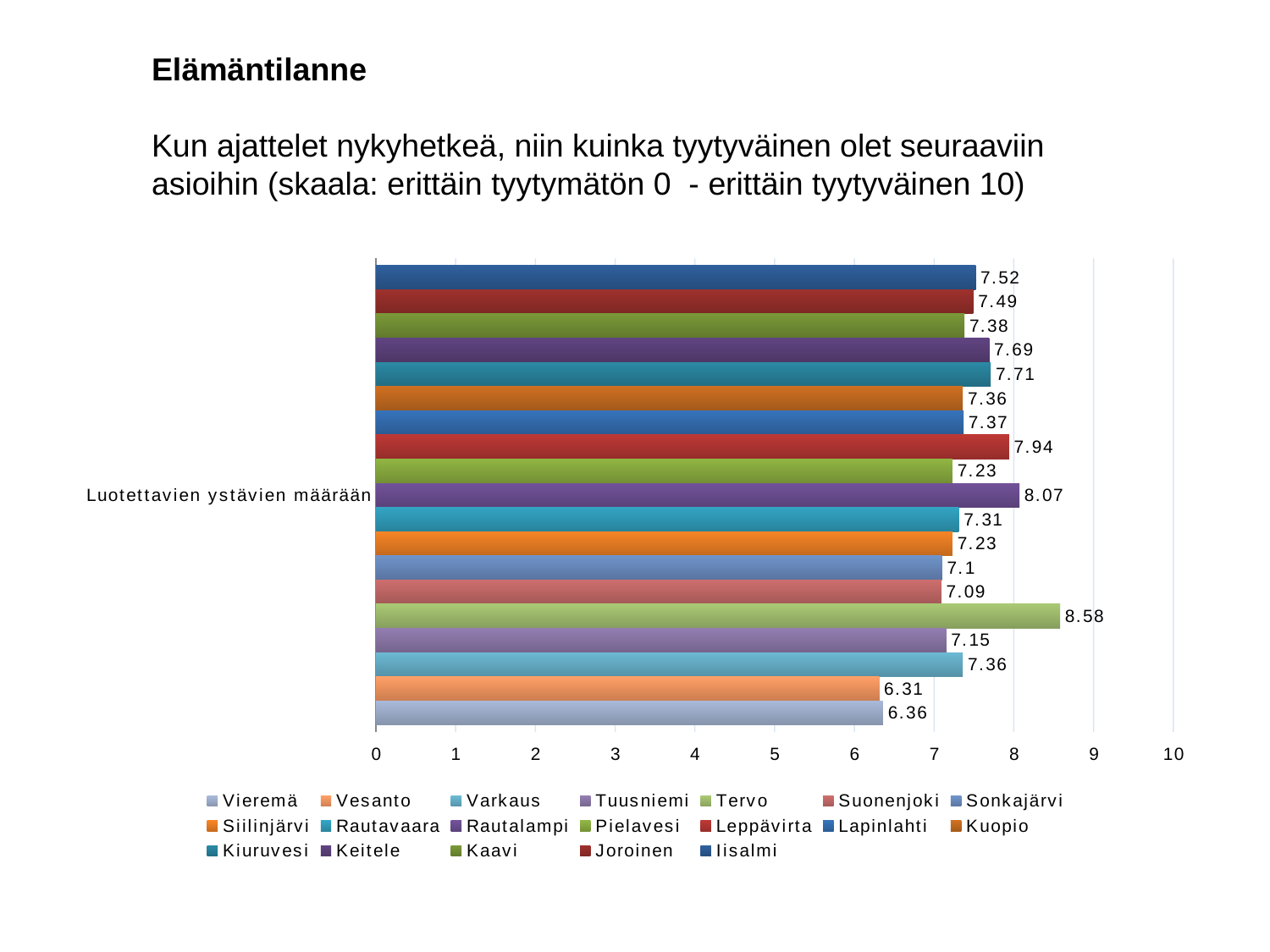
What is the category label shown on the vertical axis of the chart? Luotettavien ystävien määrään Which municipality has the highest value for Luotettavien ystävien määrään? Tervo Which is larger, the value for Kiuruvesi or the value for Kaavi? Kiuruvesi What kind of chart is shown on the slide? bar chart What is the value for Tervo? 8.58 What is the value for Leppävirta? 7.94 Is the value for Iisalmi greater or less than 7? greater How many series does the legend list? 19 What is the difference between the values for Tervo and Vesanto? 2.27 What is the value for Vieremä? 6.36 Which municipality has the lowest value for Luotettavien ystävien määrään? Vesanto What is the value for Rautalampi? 8.07